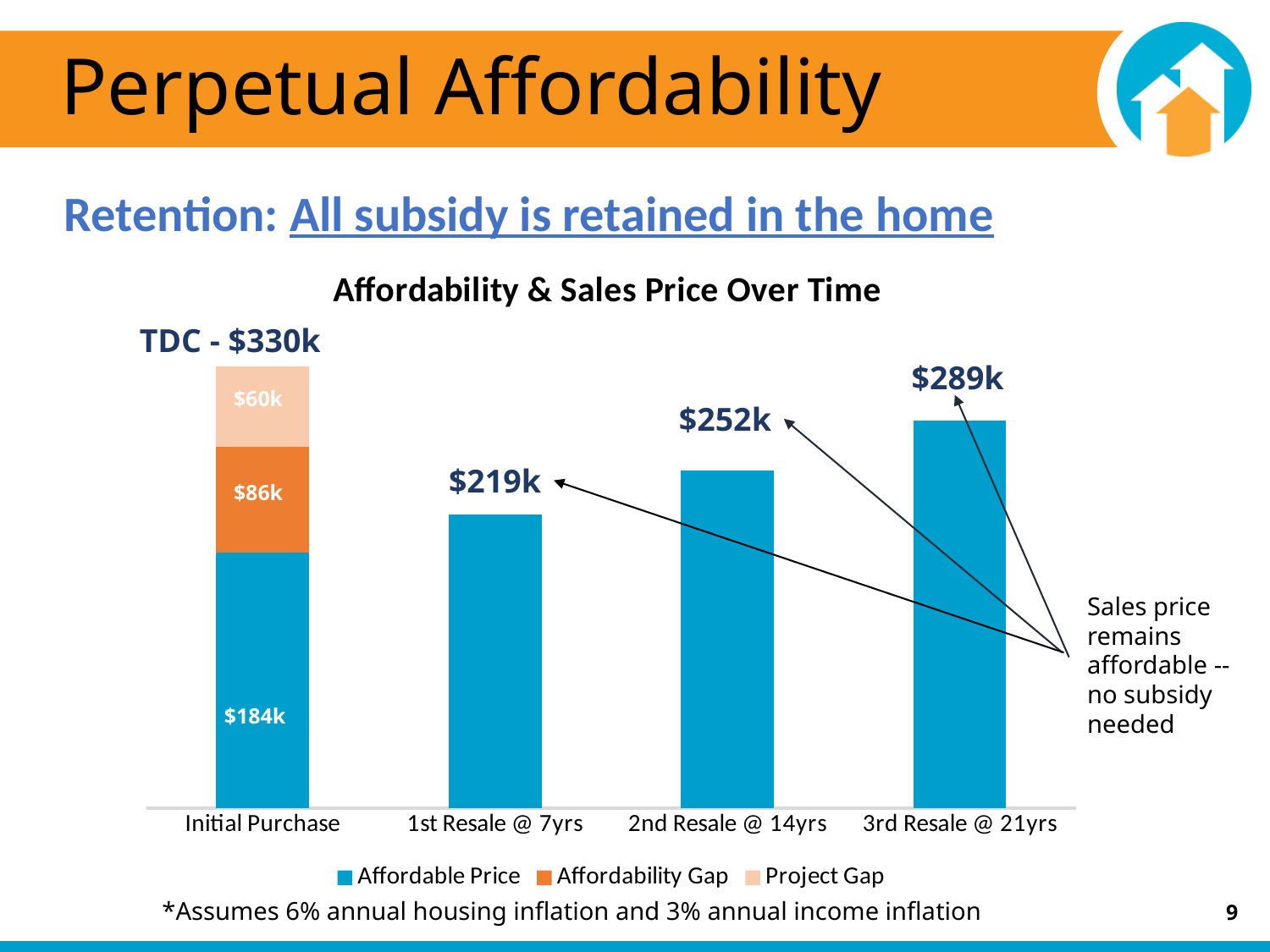
How many series does the chart legend list? 3 How many categories are shown on the x axis of the chart? 4 Do the sales prices rise or fall from the 1st Resale to the 3rd Resale? Rise What is the title of the chart? Affordability & Sales Price Over Time What is the Affordability Gap for the Initial Purchase? $86k Which resale has the highest sales price? 3rd Resale @ 21yrs What is the difference between the sales price at the 3rd Resale @ 21yrs and the 1st Resale @ 7yrs? $70k What type of chart is shown on the slide? Stacked bar chart What is the Affordable Price for the Initial Purchase? $184k What is the total of the stacked bar for the Initial Purchase (TDC)? $330k What is the value shown for the 2nd Resale @ 14yrs? $252k What is the Project Gap for the Initial Purchase? $60k